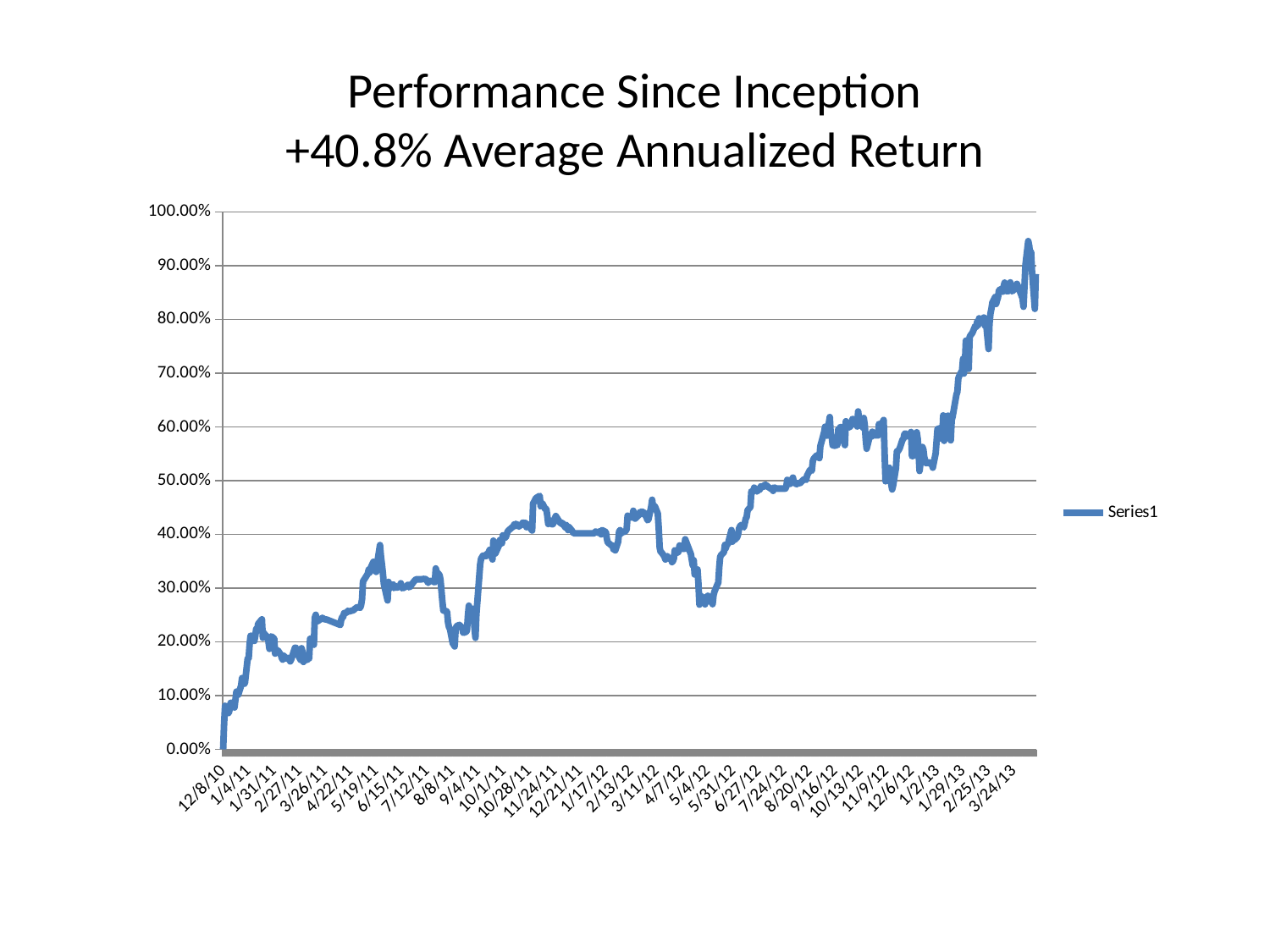
Is the value around 5/4/12 greater or less than 30%? less What is the title of the chart? Performance Since Inception +40.8% Average Annualized Return Is the value around 9/16/12 greater or less than 50%? greater Is the value around 3/26/11 greater or less than 20%? greater Which is larger, the value around 9/16/12 or the value around 5/4/12? 9/16/12 What is the value at the first date, 12/8/10? 0.00% What is the name of the series shown in the legend? Series1 Overall, do the values rise or fall from 12/8/10 to 3/24/13? rise How many series does the legend list? 1 What kind of chart is shown on the slide? line chart How many date labels are shown on the x axis? 32